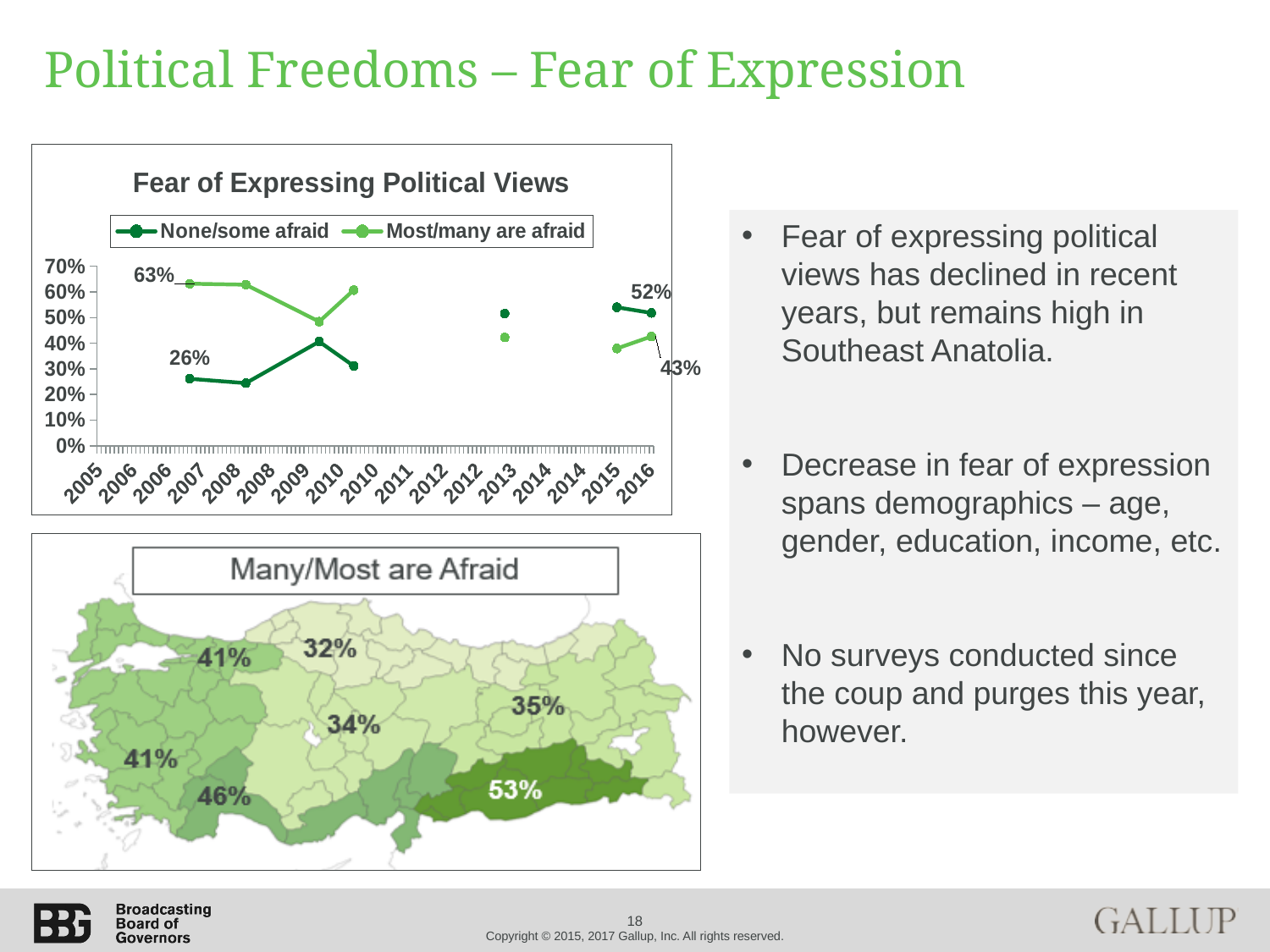
What kind of chart is 'Fear of Expressing Political Views'? line chart In the 'Fear of Expressing Political Views' chart, what is the difference between the first labeled values of the two series (63% and 26%)? 37 percentage points In the 'Fear of Expressing Political Views' chart, what is the first labeled value for the 'None/some afraid' series? 26% In the 'Fear of Expressing Political Views' chart, what is the labeled 2016 value for 'Most/many are afraid'? 43% How many series does the legend of the 'Fear of Expressing Political Views' chart list? 2 In the 'Fear of Expressing Political Views' chart, is the 2013 value for 'Most/many are afraid' greater or less than 50%? less In the 'Fear of Expressing Political Views' chart, what is the labeled 2016 value for 'None/some afraid'? 52% In the 'Fear of Expressing Political Views' chart, what is the first labeled value for the 'Most/many are afraid' series? 63% In the 'Fear of Expressing Political Views' chart, does the 'Most/many are afraid' series rise or fall overall from 2007 to 2016? fall In the 'Fear of Expressing Political Views' chart, which series has the higher value in 2016? None/some afraid On the 'Many/Most are Afraid' map, what is the lowest percentage shown? 32% On the 'Many/Most are Afraid' map, what is the highest percentage shown? 53%